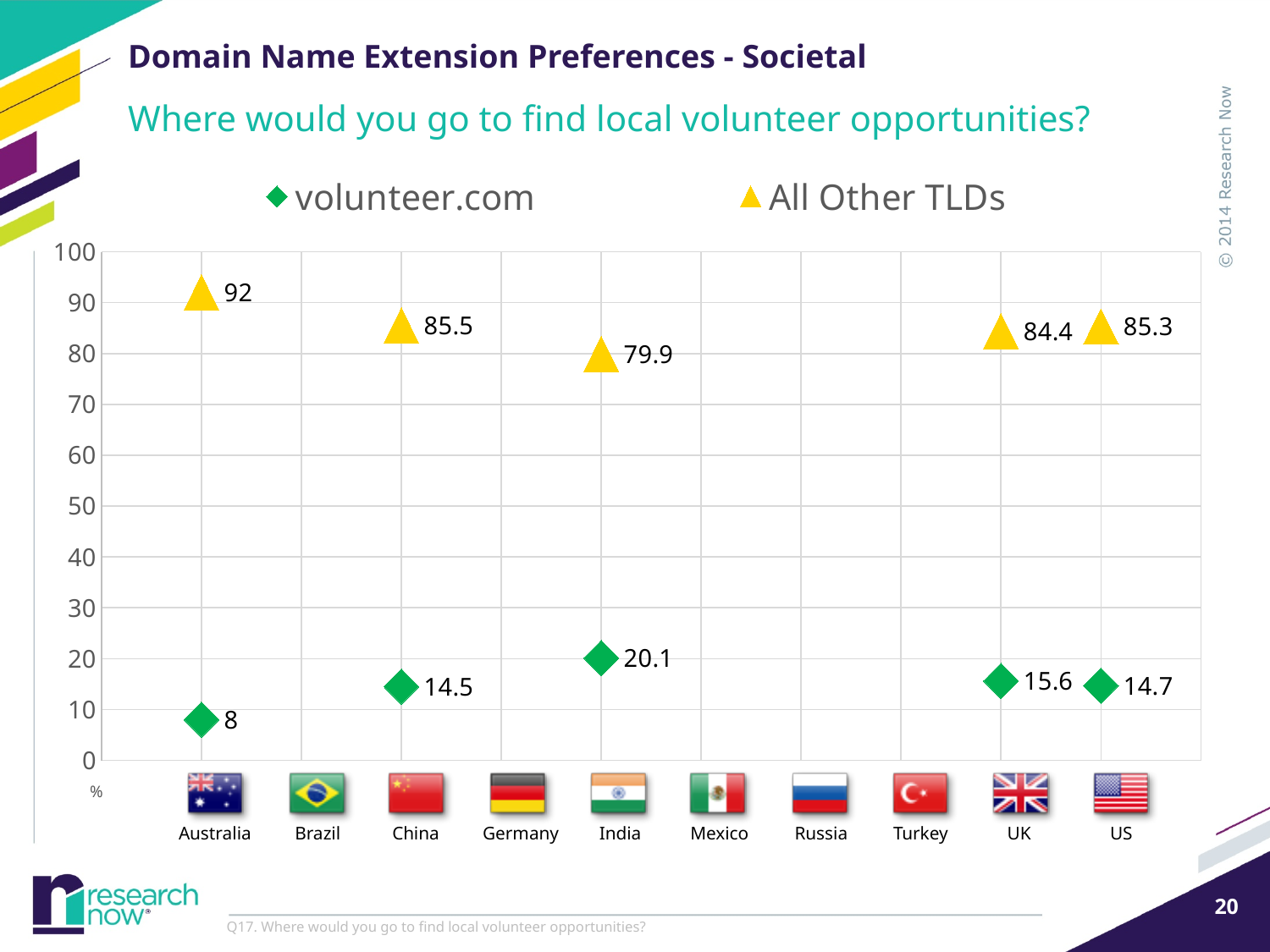
Which country has the highest value for volunteer.com? India Which country has the highest value for All Other TLDs? Australia Is the volunteer.com value for China greater or less than 20? less How many series does the legend list? 2 What is the value for All Other TLDs for Australia? 92 Which is larger, the volunteer.com value for the UK or for the US? UK How many countries are listed along the x axis? 10 What is the value for All Other TLDs for the US? 85.3 What is the difference between the All Other TLDs value and the volunteer.com value for Australia? 84 What is the value for volunteer.com for India? 20.1 What is the value for volunteer.com for the UK? 15.6 Which country has the lowest value for All Other TLDs? India